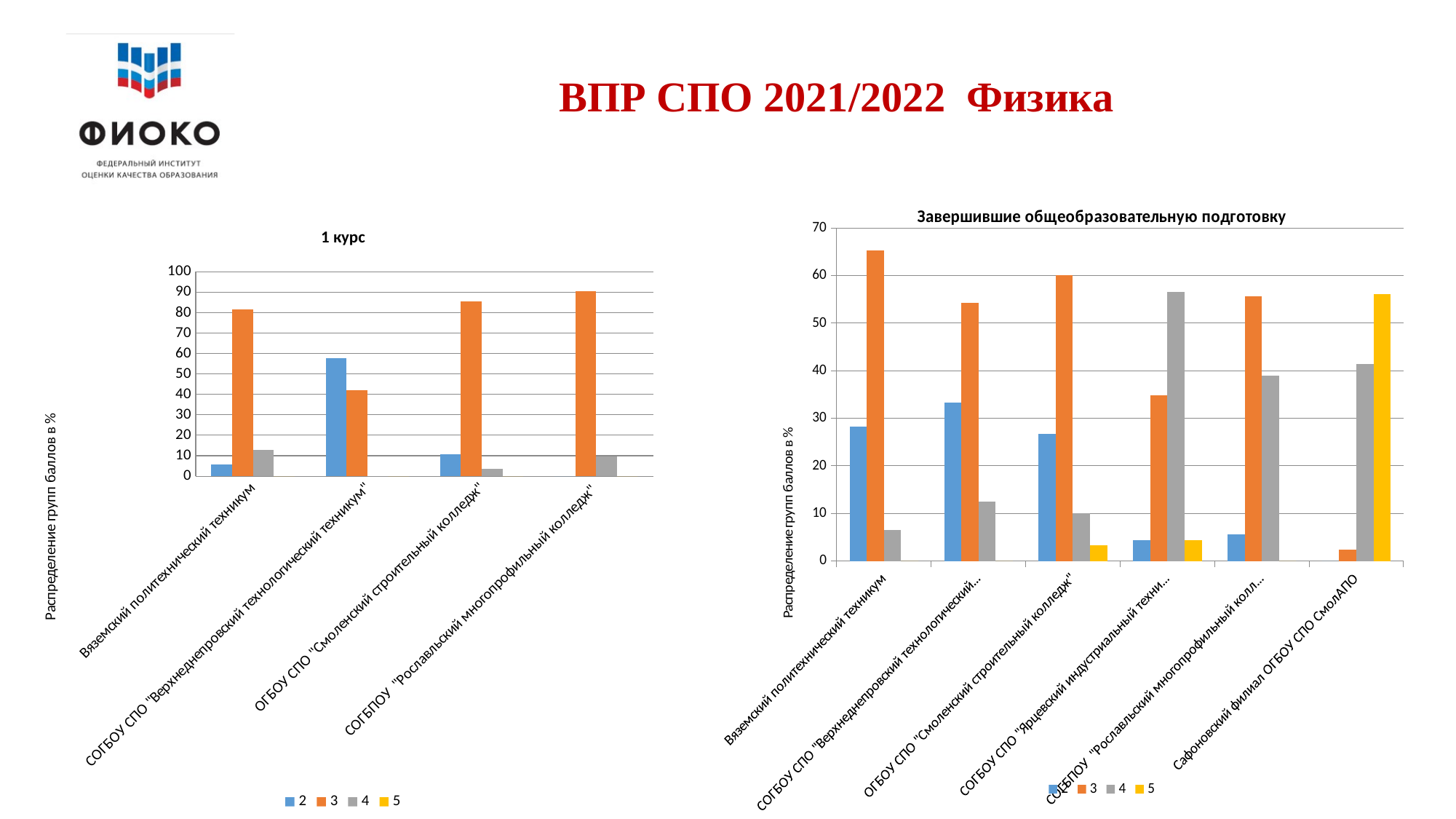
In the chart titled "1 курс", is the value of series 3 for Вяземский политехнический техникум greater or less than 70? greater In the chart titled "1 курс", which category has the highest value for series 3? СОГБПОУ "Рославльский многопрофильный колледж" In the chart titled "1 курс", which is larger for СОГБОУ СПО "Верхнеднепровский технологический техникум": series 2 or series 3? series 2 How many series does the legend of the chart titled "1 курс" list? 4 What kind of chart is the chart titled "1 курс"? bar chart How many categories are shown on the x axis of the chart titled "Завершившие общеобразовательную подготовку"? 6 In the chart titled "1 курс", is the value of series 2 for СОГБОУ СПО "Верхнеднепровский технологический техникум" greater or less than 50? greater In the chart titled "Завершившие общеобразовательную подготовку", is the value of series 3 for Вяземский политехнический техникум greater or less than 60? greater In the chart titled "Завершившие общеобразовательную подготовку", which category has the highest value for series 5? Сафоновский филиал ОГБОУ СПО СмолАПО What is the y-axis label of the chart titled "1 курс"? Распределение групп баллов в % In the chart titled "Завершившие общеобразовательную подготовку", which is larger for Сафоновский филиал ОГБОУ СПО СмолАПО: series 4 or series 5? series 5